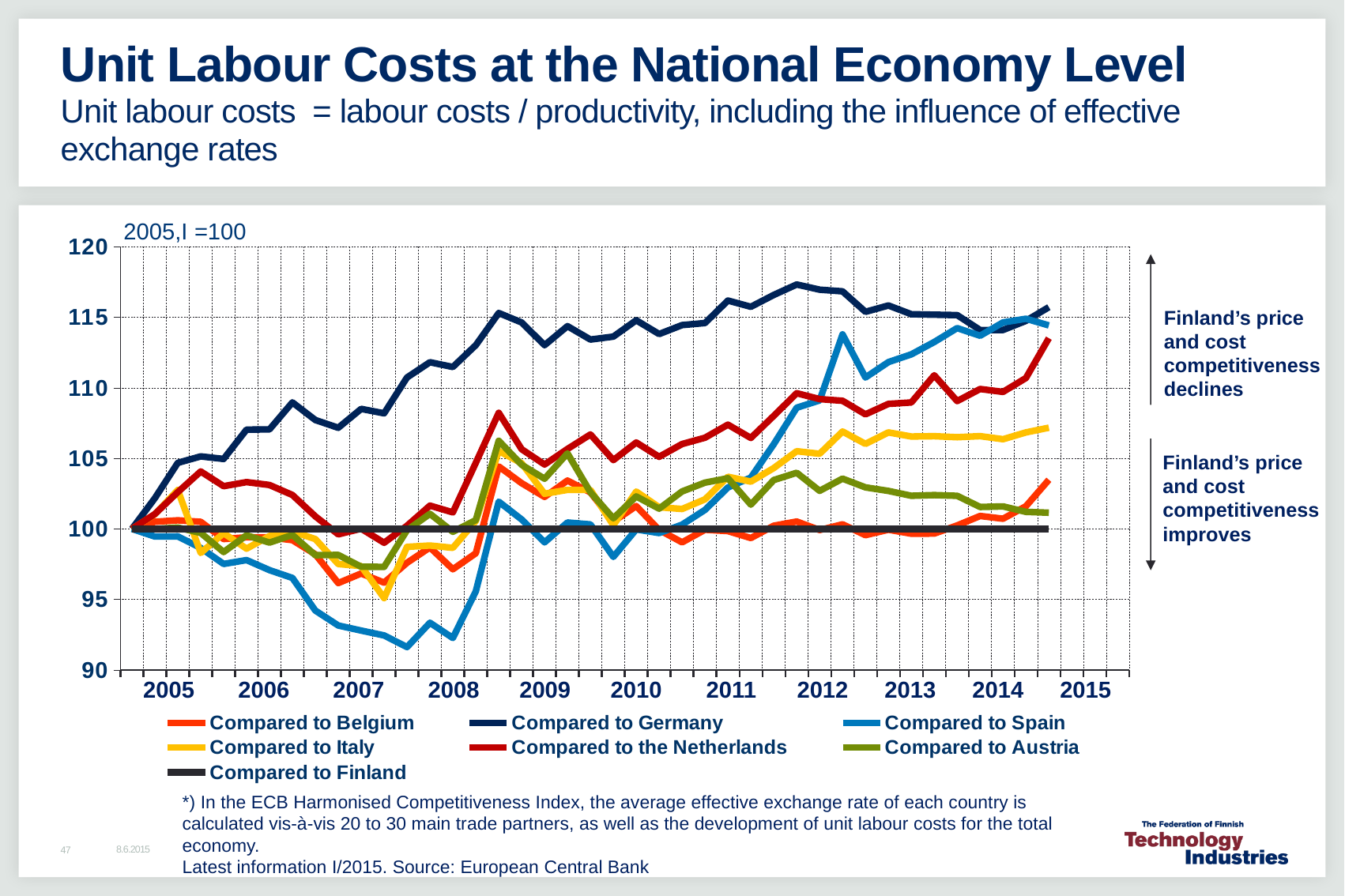
Which series is the highest in 2010? Compared to Germany How many series does the legend list? 7 Is the value for 'Compared to Spain' in 2007 greater or less than 95? less Does the 'Compared to Spain' line rise or fall between 2010 and 2012? rise What value does the 'Compared to Finland' line stay at throughout the chart? 100 In 2010, which is larger: 'Compared to Germany' or 'Compared to the Netherlands'? Compared to Germany Is the value for 'Compared to Italy' at the end of the series (2014) greater or less than 105? greater How many year labels are shown on the x axis? 11 Which series is the lowest in 2007? Compared to Spain What kind of chart is shown on the slide? line chart What is the base value of the index, as stated above the chart? 2005,I =100 Is the value for 'Compared to Germany' in 2012 greater or less than 115? greater